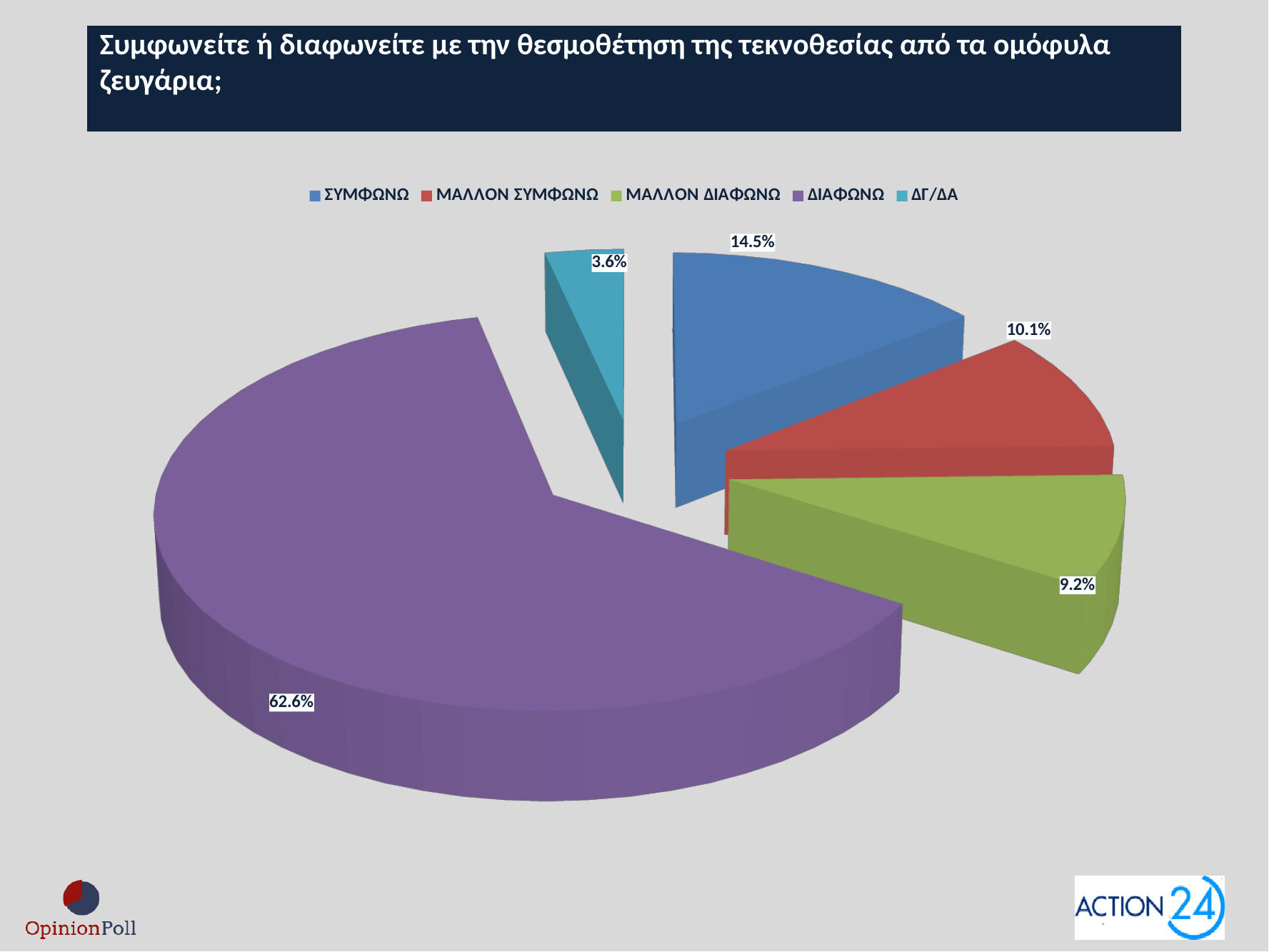
Which category has the smallest share of the pie? ΔΓ/ΔΑ What is the value for ΔΙΑΦΩΝΩ? 62.6% What colour is the slice for ΔΙΑΦΩΝΩ? Purple What is the value for ΔΓ/ΔΑ? 3.6% What is the value for ΜΑΛΛΟΝ ΔΙΑΦΩΝΩ? 9.2% What is the value for ΜΑΛΛΟΝ ΣΥΜΦΩΝΩ? 10.1% What is the value for ΣΥΜΦΩΝΩ? 14.5% How many categories does the legend list? 5 What is the difference between the values for ΔΙΑΦΩΝΩ and ΣΥΜΦΩΝΩ? 48.1% Which category has the largest share of the pie? ΔΙΑΦΩΝΩ Which is larger, the value for ΣΥΜΦΩΝΩ or the value for ΜΑΛΛΟΝ ΣΥΜΦΩΝΩ? ΣΥΜΦΩΝΩ What type of chart is shown on the slide? Pie chart